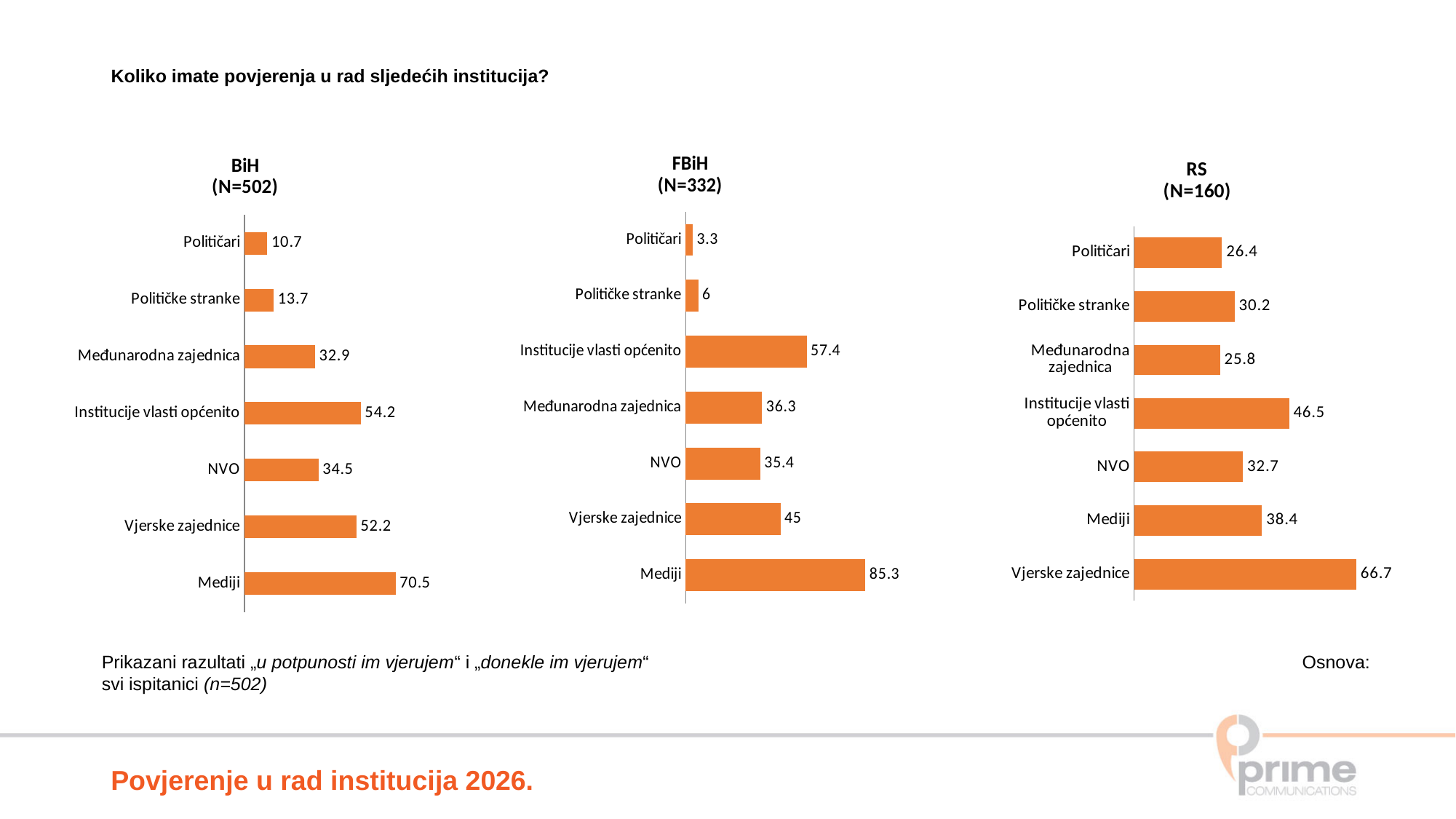
How many categories are shown in the FBiH (N=332) chart? 7 In the BiH (N=502) chart, what is the value for Mediji? 70.5 In the RS (N=160) chart, which is larger: the value for Mediji or the value for NVO? Mediji How many charts are shown on the slide? 3 In the RS (N=160) chart, what is the value for Institucije vlasti općenito? 46.5 In the FBiH (N=332) chart, which category has the lowest value? Političari In the FBiH (N=332) chart, what is the value for Političari? 3.3 In the BiH (N=502) chart, which is larger: the value for Institucije vlasti općenito or the value for Vjerske zajednice? Institucije vlasti općenito In the RS (N=160) chart, which category has the highest value? Vjerske zajednice What type of chart is the BiH (N=502) chart? Bar chart In the BiH (N=502) chart, what is the difference between the values for Mediji and Političari? 59.8 In the FBiH (N=332) chart, what is the difference between the values for Mediji and Vjerske zajednice? 40.3